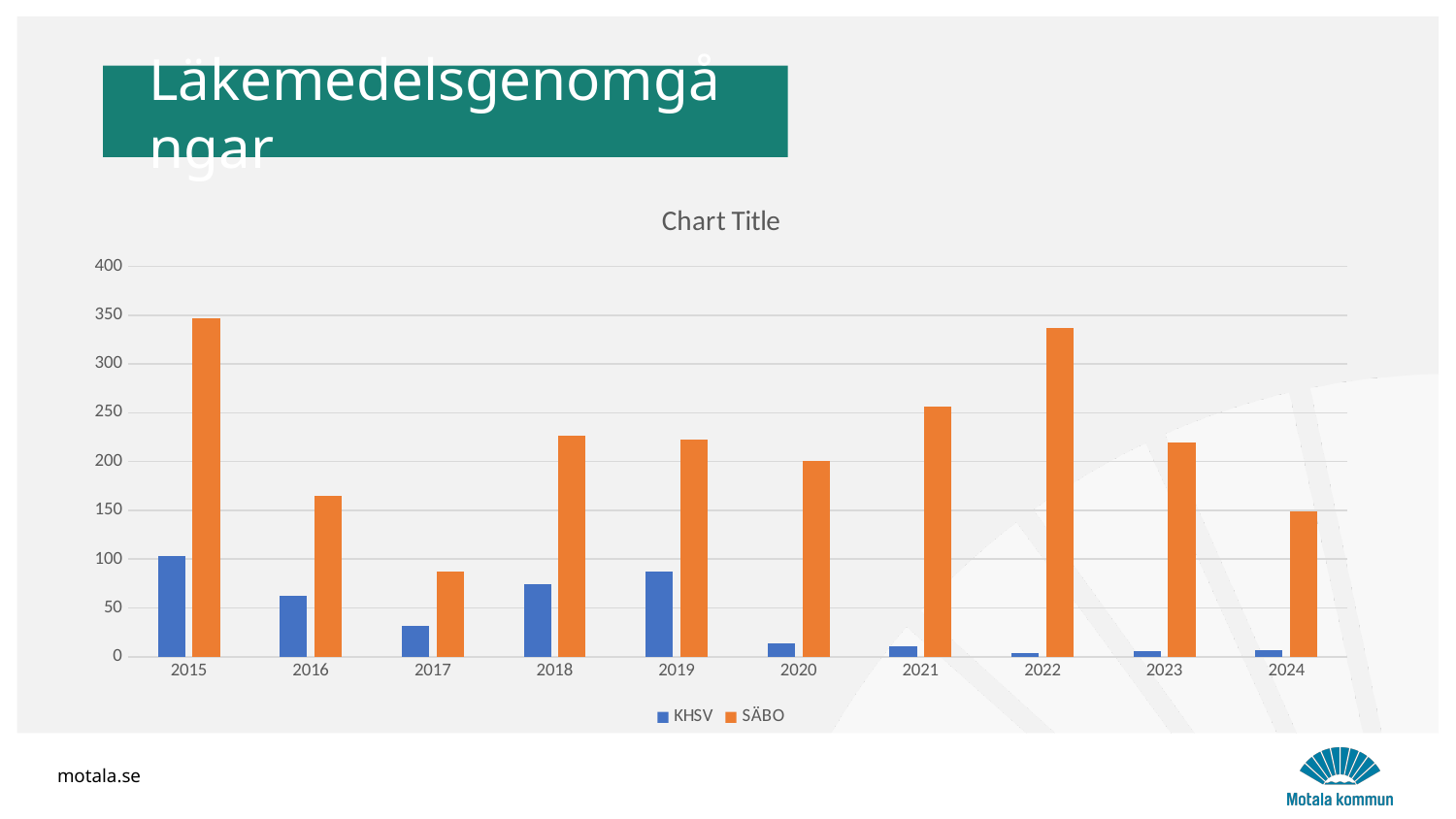
Is the KHSV value for 2020 greater or less than 50? less How many years are shown on the x axis? 10 What kind of chart is shown on the slide? Bar chart Is the SÄBO value for 2015 greater or less than 300? greater Which year has the highest KHSV value? 2015 Does the KHSV series generally rise or fall from 2015 to 2024? fall Which is larger, the SÄBO value for 2021 or for 2020? 2021 What are the two series names shown in the legend? KHSV and SÄBO Is the SÄBO value for 2017 greater or less than 100? less Which year has the lowest SÄBO value? 2017 How many series does the legend list? 2